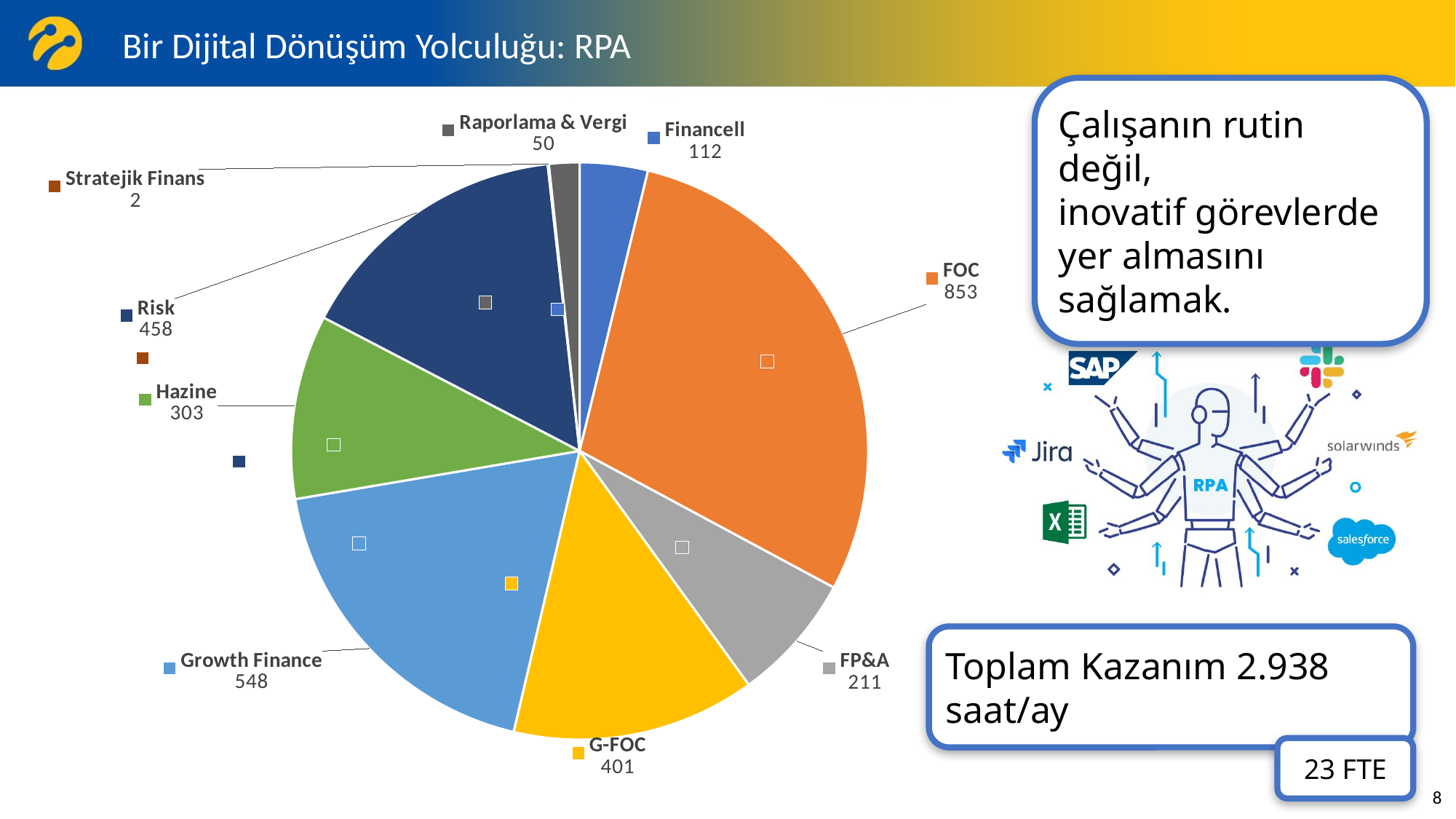
What kind of chart is shown on the slide? Pie chart Which is larger, the value for Risk or the value for G-FOC? Risk Which category has the largest slice in the pie chart? FOC What is the value for FOC in the pie chart? 853 What is the total of all the values shown in the pie chart? 2.938 How many categories are shown in the pie chart? 9 What is the difference between the values for Risk and G-FOC? 57 What is the value for Raporlama & Vergi in the pie chart? 50 Which category has the smallest slice in the pie chart? Stratejik Finans What is the difference between the values for FOC and Growth Finance? 305 What is the value for Growth Finance in the pie chart? 548 What is the value for Hazine in the pie chart? 303